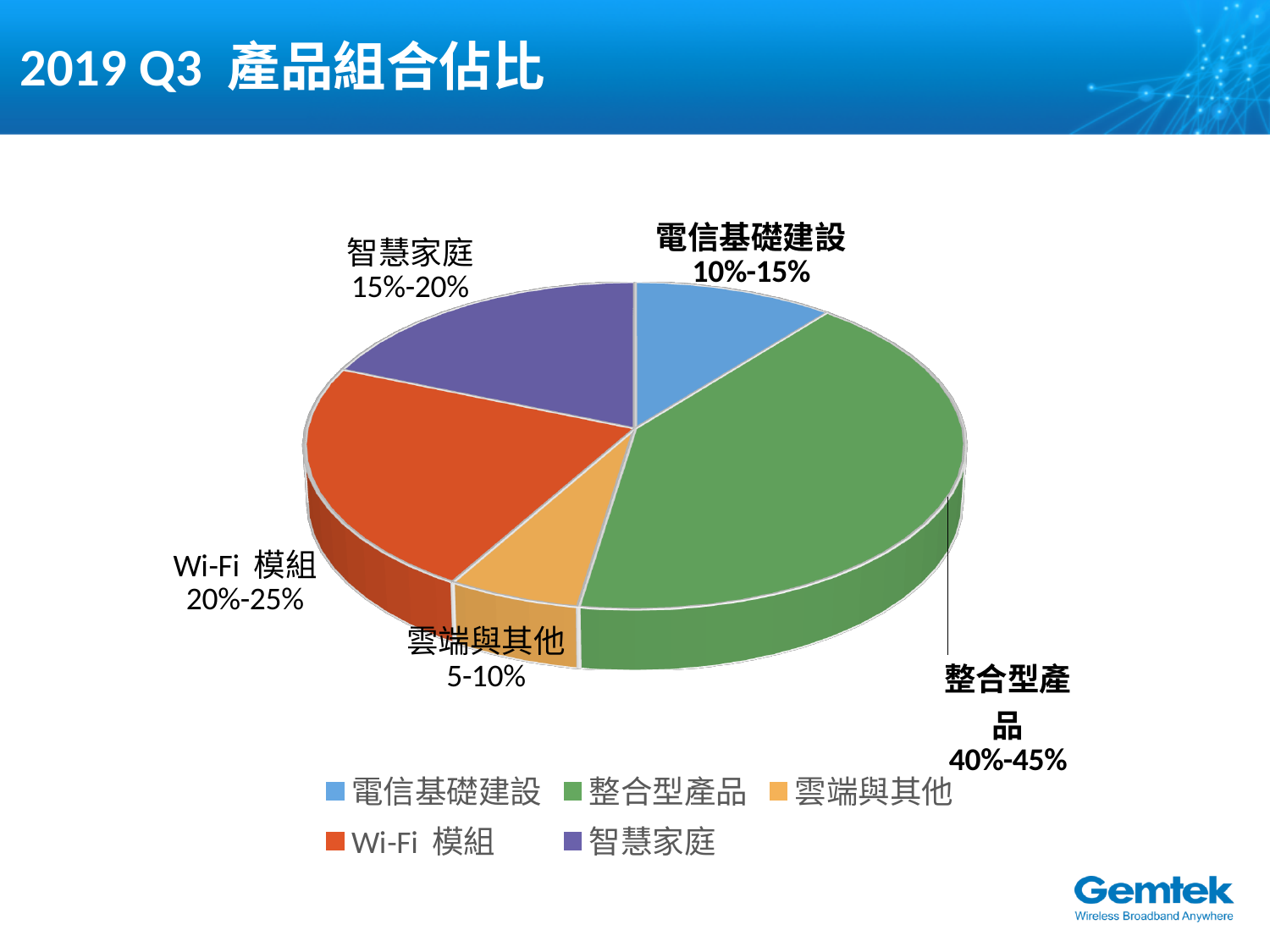
How many entries does the legend list? 5 What is the title of the slide? 2019 Q3 產品組合佔比 What kind of chart is shown on the slide? Pie chart Which category has the smallest slice of the pie? 雲端與其他 How many slices does the pie chart have? 5 What share of the product mix is labelled for 整合型產品? 40%-45% What share is shown for 雲端與其他? 5-10% Which has a larger share, Wi-Fi 模組 or 智慧家庭? Wi-Fi 模組 What share is shown for Wi-Fi 模組? 20%-25% Which category has the largest slice of the pie? 整合型產品 What share is shown for 智慧家庭? 15%-20% What share is shown for 電信基礎建設? 10%-15%